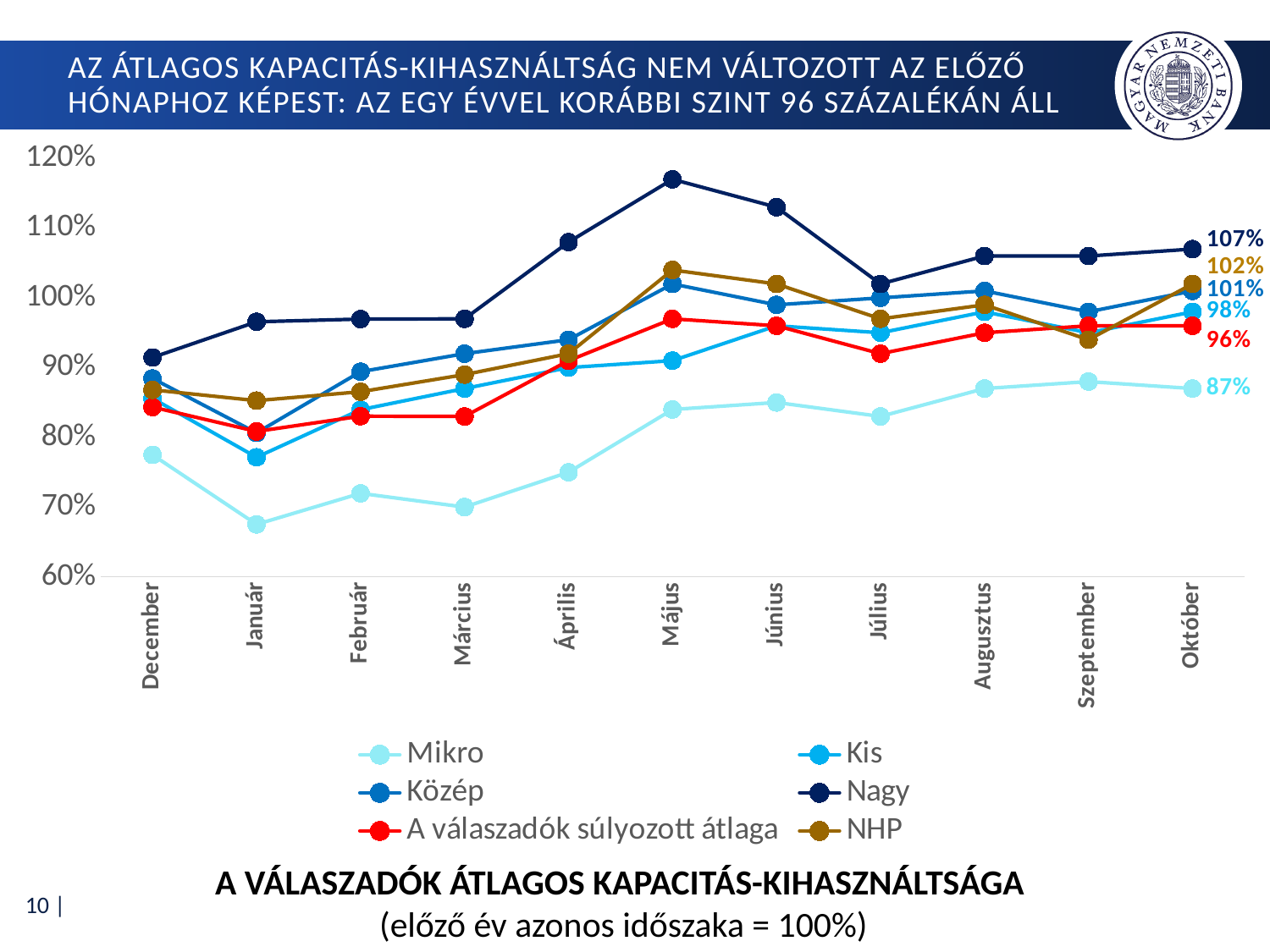
Which series has the highest value in Október? Nagy Is the value for Nagy in Május greater or less than 110%? greater What is the difference between the Nagy and Mikro values in Október? 20% What kind of chart is shown on the slide? line chart What is the value for Mikro in Október? 87% Which series has the lowest value in Október? Mikro What is the value for A válaszadók súlyozott átlaga in Október? 96% Is the value for Mikro in Január greater or less than 70%? less What is the value for Nagy in Október? 107% How many months are shown on the x axis? 11 What is the value for NHP in Október? 102% How many series does the legend list? 6